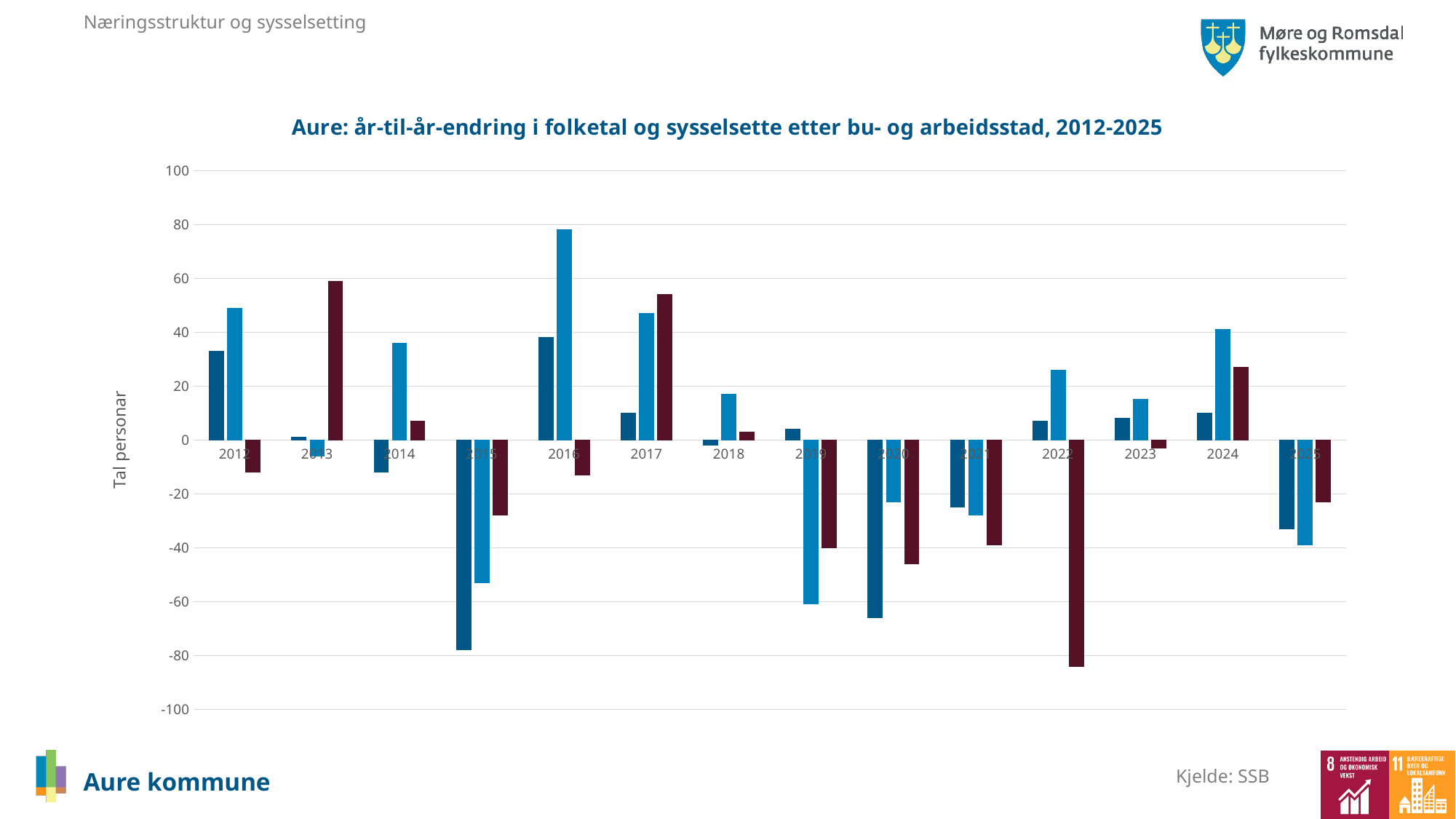
What is the label on the vertical axis of the chart? Tal personar Is the light blue bar for 2016 greater or less than 60? greater Which is larger, the light blue bar for 2024 or the light blue bar for 2023? 2024 What kind of chart is shown on the slide? bar chart How many years are shown along the x axis of the chart? 14 Is the dark blue bar for 2020 greater or less than -60? less Is the dark red bar for 2022 greater or less than -80? less In which year is the dark blue bar the lowest? 2015 In which year is the dark red bar the lowest? 2022 In which year is the light blue bar the highest? 2016 What is the title of the chart? Aure: år-til-år-endring i folketal og sysselsette etter bu- og arbeidsstad, 2012-2025 Which is larger, the dark red bar for 2013 or the dark red bar for 2014? 2013